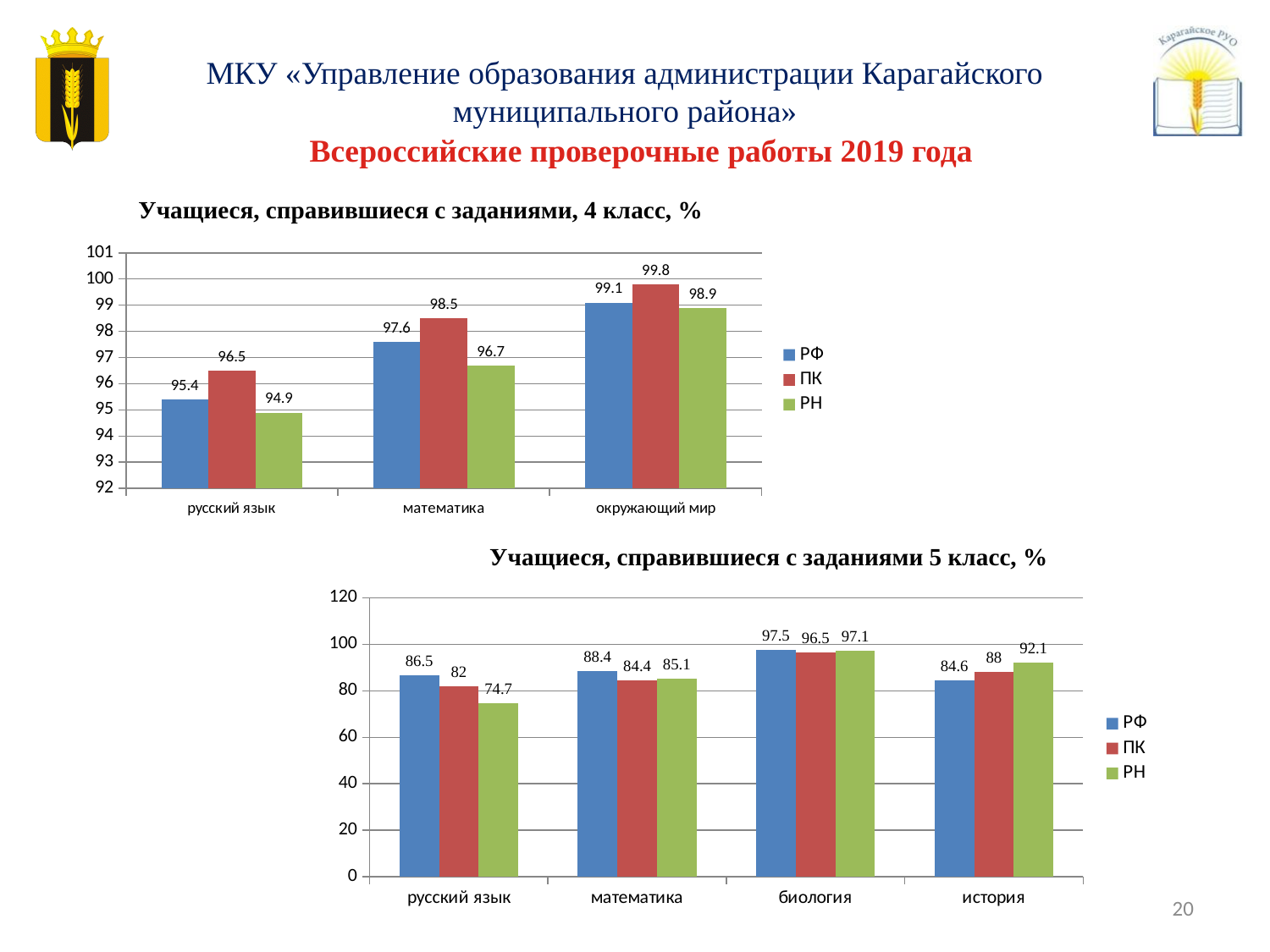
In the chart 'Учащиеся, справившиеся с заданиями, 4 класс, %', how many series does the legend list? 3 In the chart 'Учащиеся, справившиеся с заданиями, 4 класс, %', do the values for РФ rise or fall from русский язык to окружающий мир? rise In the chart 'Учащиеся, справившиеся с заданиями 5 класс, %', which is larger in история: РФ or РН? РН In the chart 'Учащиеся, справившиеся с заданиями, 4 класс, %', what is the value for РН in русский язык? 94.9 What kind of chart is 'Учащиеся, справившиеся с заданиями 5 класс, %'? bar chart In the chart 'Учащиеся, справившиеся с заданиями 5 класс, %', what is the value for РН in русский язык? 74.7 In the chart 'Учащиеся, справившиеся с заданиями, 4 класс, %', which category has the highest value for РФ? окружающий мир In the chart 'Учащиеся, справившиеся с заданиями, 4 класс, %', what is the value for ПК in математика? 98.5 In the chart 'Учащиеся, справившиеся с заданиями 5 класс, %', what is the value for ПК in история? 88 In the chart 'Учащиеся, справившиеся с заданиями 5 класс, %', which category has the lowest value for РН? русский язык In the chart 'Учащиеся, справившиеся с заданиями, 4 класс, %', what is the difference between ПК and РН in окружающий мир? 0.9 In the chart 'Учащиеся, справившиеся с заданиями 5 класс, %', how many categories are shown on the x axis? 4